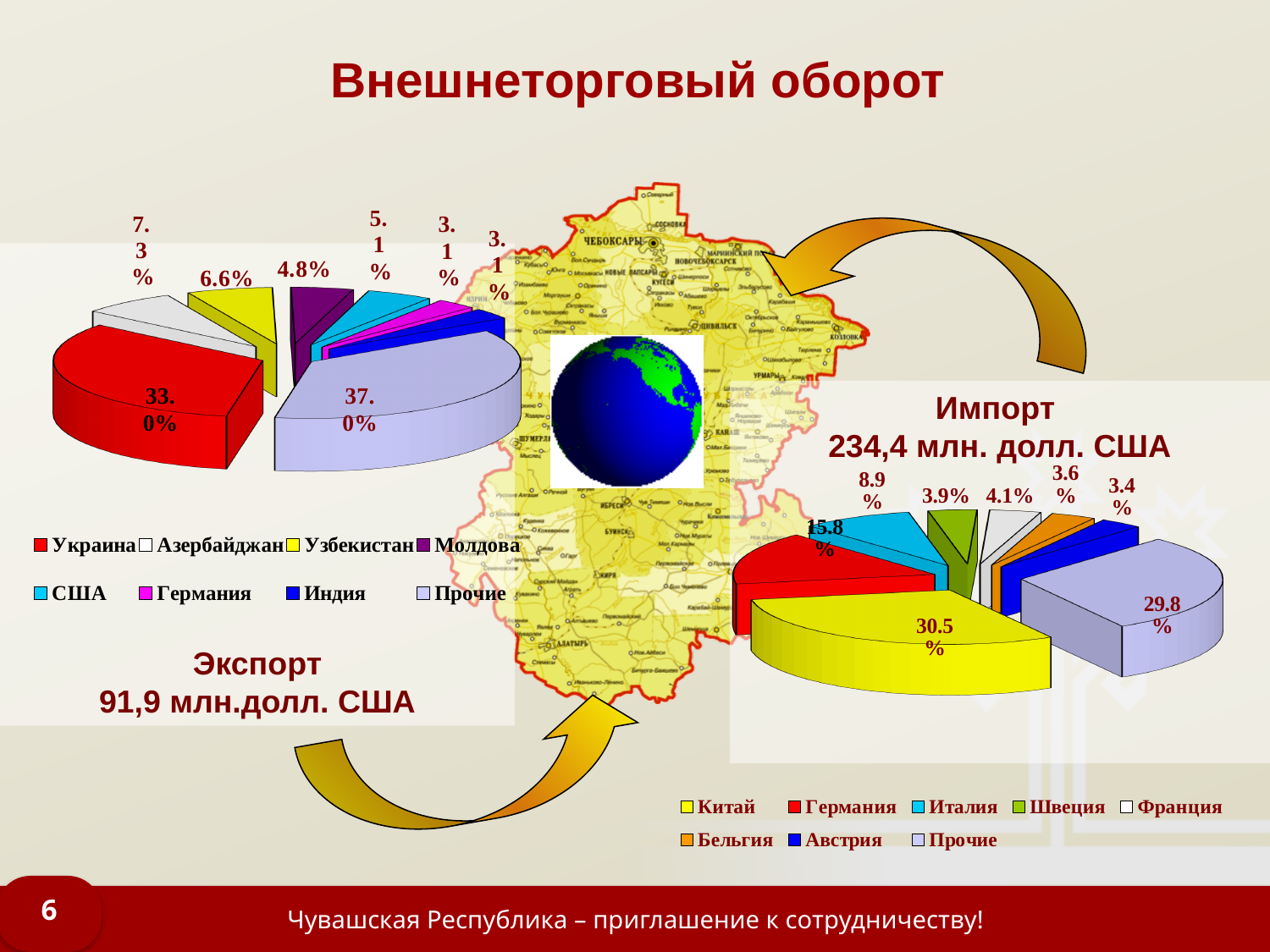
In the Импорт pie chart, what share does Германия have? 15.8% In the Импорт pie chart, which category has the smallest slice? Австрия In the Экспорт pie chart, which category has the largest slice? Прочие In the Экспорт pie chart, what share does Азербайджан have? 7.3% In the Экспорт pie chart, which is larger, Украина or Узбекистан? Украина What kind of chart is used for the Экспорт data on the left of the slide? Pie chart In the Экспорт pie chart, what share does Прочие have? 37.0% How many categories does the legend of the Импорт pie chart list? 8 In the Импорт pie chart, what share does Китай have? 30.5% In the Экспорт pie chart, what share does Украина have? 33.0% In the Импорт pie chart, what is the difference between the shares of Китай and Прочие? 0.7 percentage points What total import value is stated next to the Импорт pie chart? 234,4 млн. долл. США